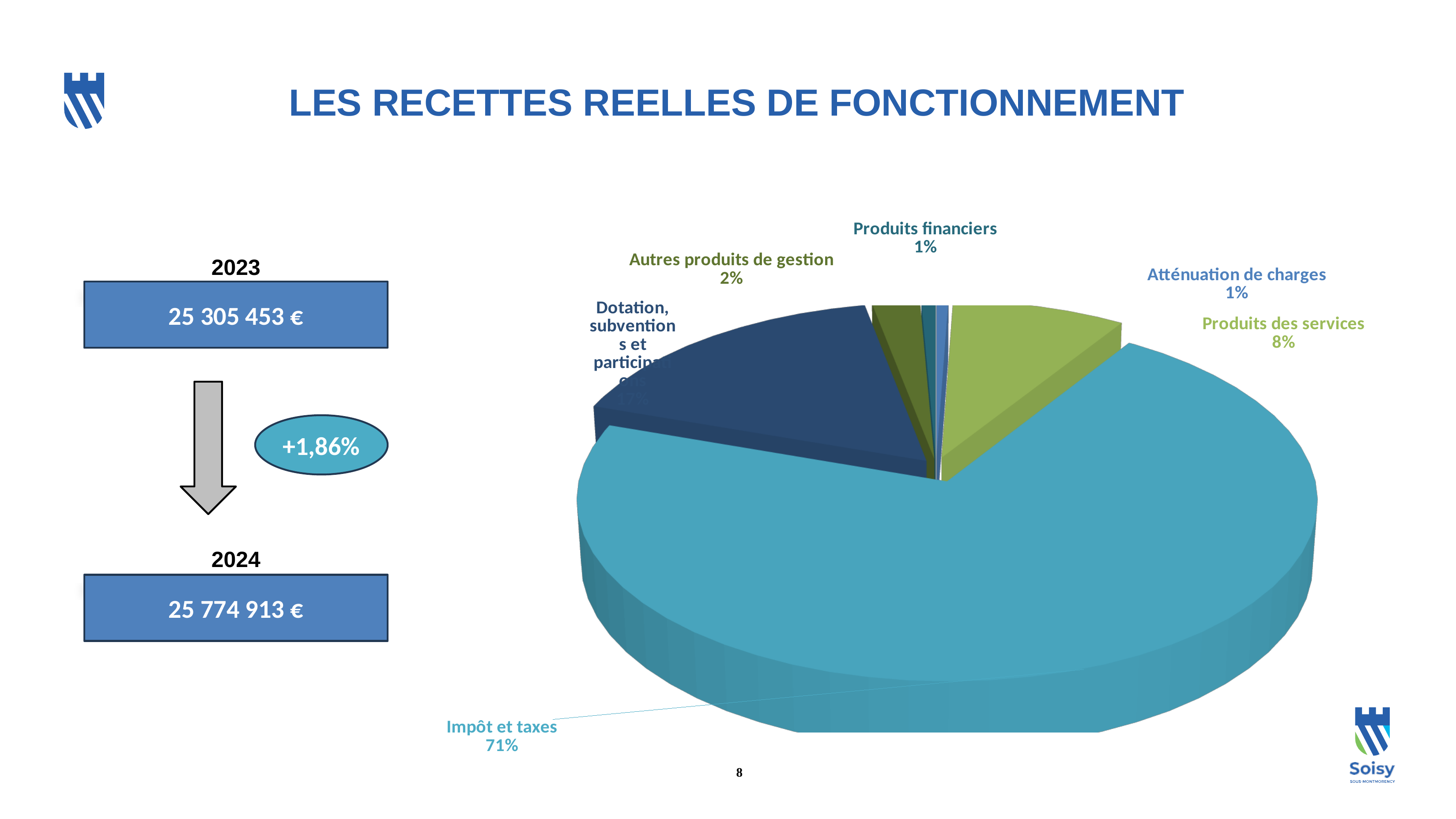
What is the value shown for Produits des services? 8% What is the title of the slide containing the pie chart? LES RECETTES REELLES DE FONCTIONNEMENT What kind of chart is shown on the slide? pie chart What is the difference between the shares of Impôt et taxes and Produits des services? 63% Which is larger, Produits des services or Autres produits de gestion? Produits des services What is the value shown for Atténuation de charges? 1% Which category has the largest slice of the pie? Impôt et taxes What is the value shown for Dotation, subventions et participations? 17% What share of the pie does Impôt et taxes represent? 71% What is the value shown for Produits financiers? 1% How many slices does the pie chart have? 6 What is the value shown for Autres produits de gestion? 2%